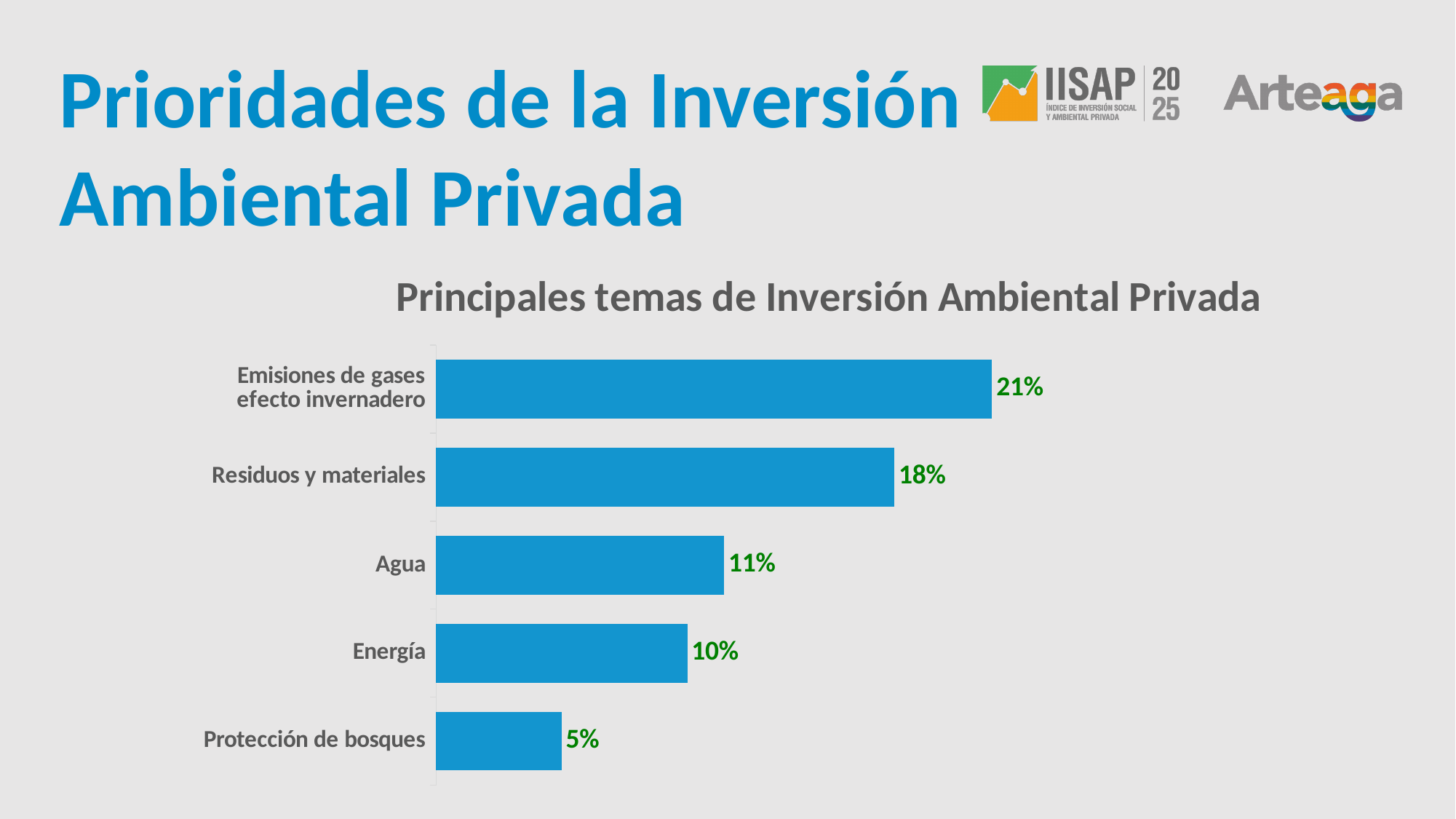
What is the difference between the values for Energía and Protección de bosques? 5% What is the value for Residuos y materiales? 18% What is the value for Emisiones de gases efecto invernadero? 21% Which category has the lowest value? Protección de bosques How many categories are shown in the chart? 5 What is the value for Protección de bosques? 5% Which category has the highest value? Emisiones de gases efecto invernadero Which is larger, the value for Agua or the value for Energía? Agua What kind of chart is shown on the slide? Bar chart What is the value for Agua? 11% What is the title of the chart? Principales temas de Inversión Ambiental Privada What is the difference between the values for Emisiones de gases efecto invernadero and Residuos y materiales? 3%